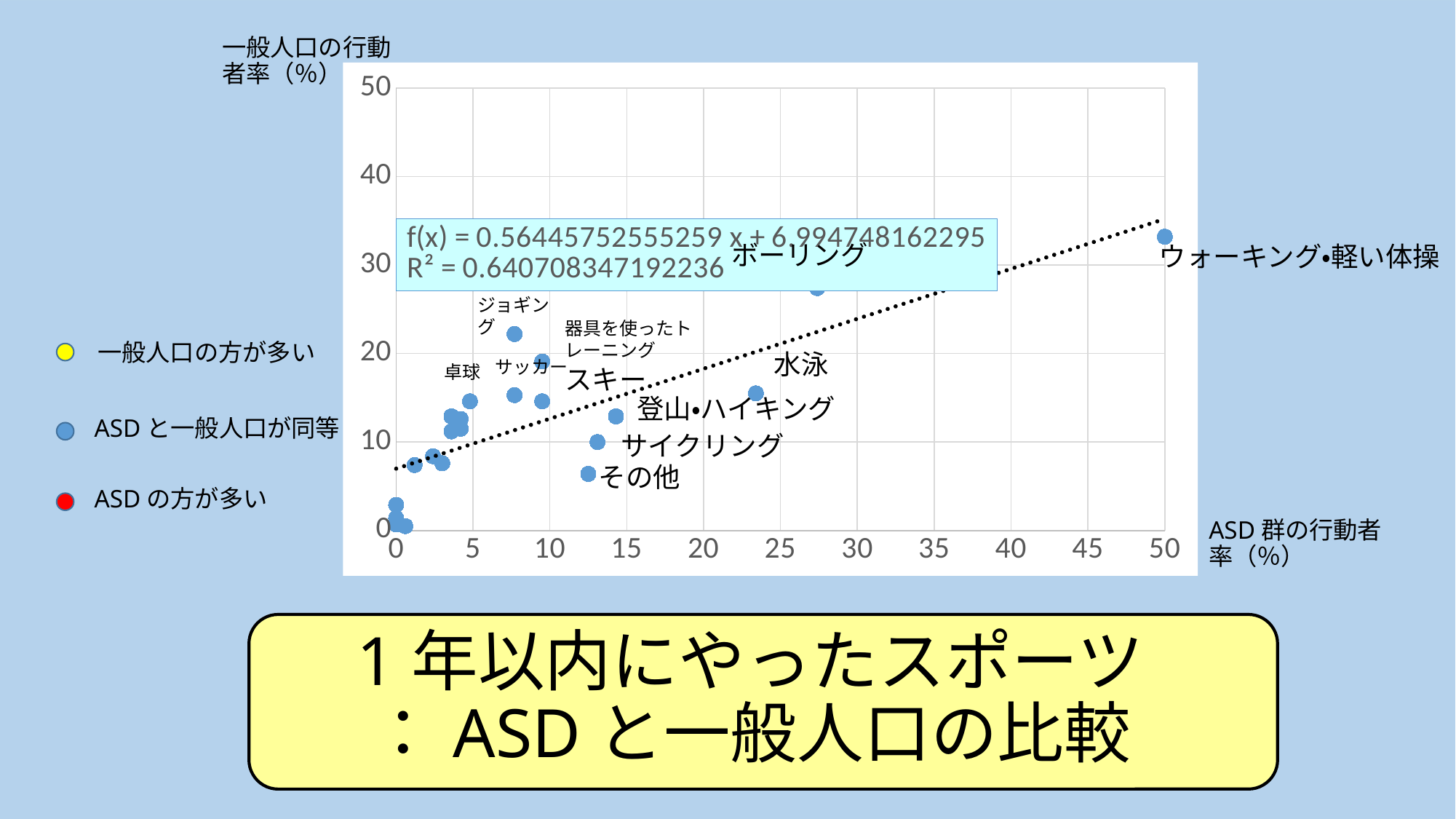
Is the 一般人口の行動者率 value for その他 greater or less than 10? less What kind of chart is shown on the slide? scatter chart What is the title shown below the chart? １年以内にやったスポーツ：ASDと一般人口の比較 Is the ASD群の行動者率 value for ウォーキング•軽い体操 greater or less than 45? greater Which labelled sport has the highest value on the vertical axis (一般人口の行動者率)? ウォーキング•軽い体操 Which has the higher 一般人口の行動者率 value, ジョギング or 水泳? ジョギング What R² value is printed for the trend line on the chart? 0.640708347192236 Is the 一般人口の行動者率 value for ウォーキング•軽い体操 greater or less than 30? greater Which labelled sport has the highest value on the horizontal axis (ASD群の行動者率)? ウォーキング•軽い体操